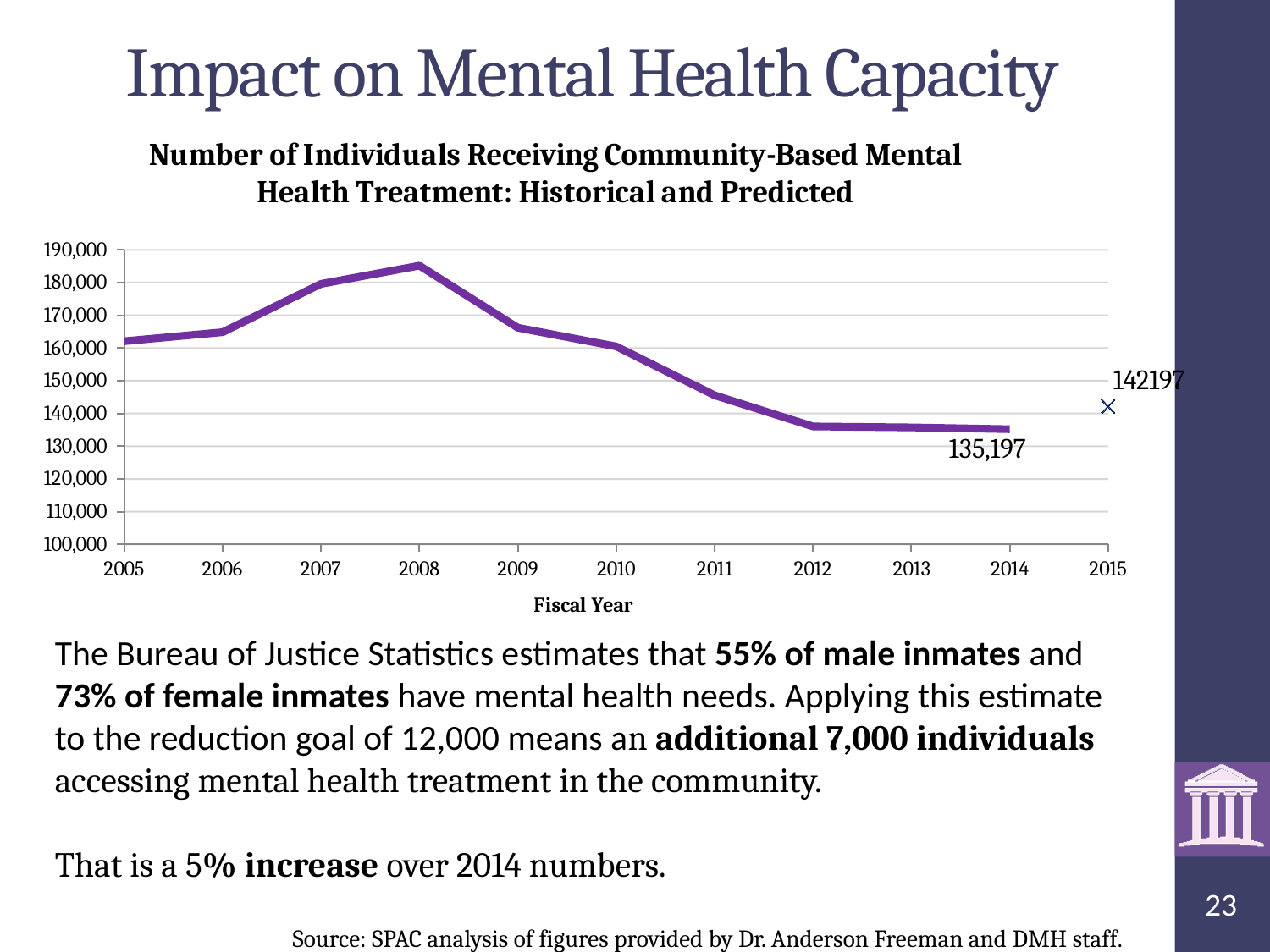
How many fiscal years are shown on the x axis? 11 Is the value for fiscal year 2008 greater or less than 180,000? greater What type of chart is shown on the slide? line chart In which fiscal year does the line reach its highest value? 2008 What is the title of the x axis? Fiscal Year What is the difference between the predicted 2015 value and the 2014 value? 7,000 What is the number of individuals receiving community-based mental health treatment in fiscal year 2014? 135,197 Is the value for fiscal year 2009 greater or less than 170,000? less Which fiscal year has the larger value, 2007 or 2011? 2007 Do the values rise or fall from fiscal year 2008 to fiscal year 2014? fall What is the predicted value shown for fiscal year 2015? 142197 Is the value for fiscal year 2011 greater or less than 150,000? less